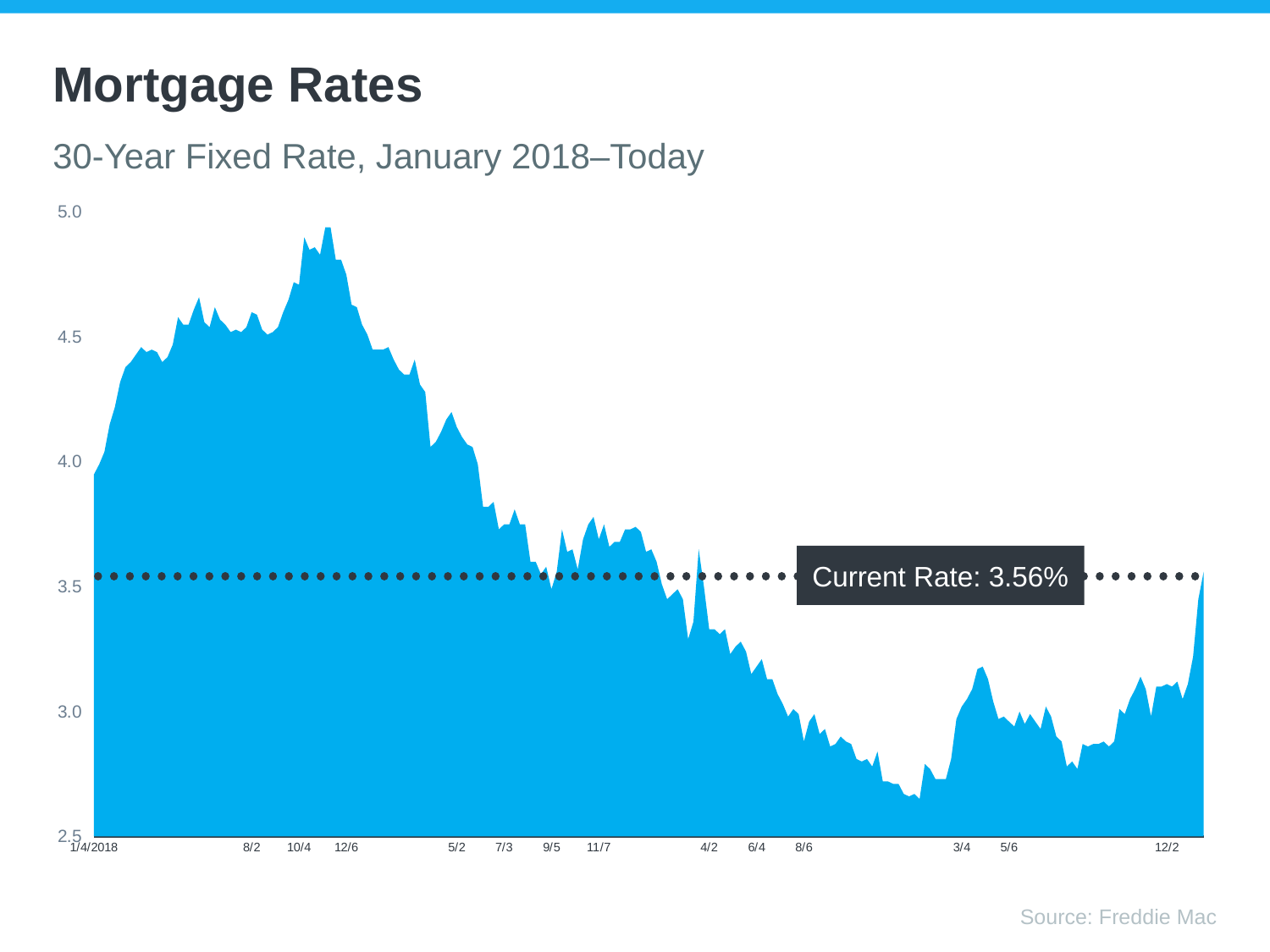
What is the current rate labelled on the chart? 3.56% What is the lowest value shown on the y axis? 2.5 Is the lowest point of the rate series greater or less than 3.0? less What is the source cited for the chart data? Freddie Mac How many date labels are shown on the x axis? 14 Is the value at 12/6 (2018) greater or less than 4.5? greater What is the title of the chart? Mortgage Rates Overall, does the mortgage rate rise or fall from January 2018 to today? fall What kind of chart is shown on the slide? area chart Is the value at 9/5 (2019) greater or less than 4.0? less